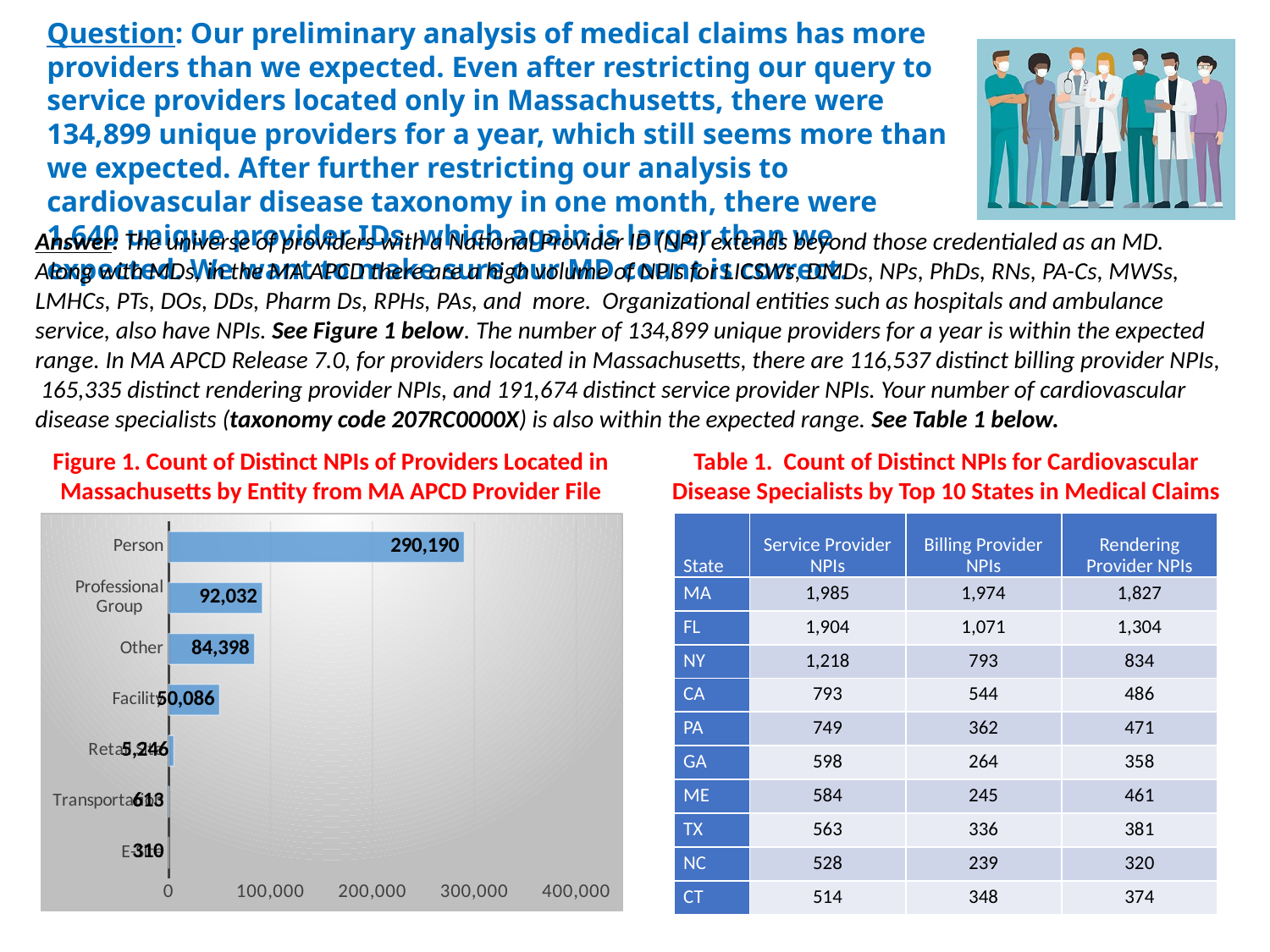
In Figure 1, which entity has the highest count of distinct NPIs? Person How many entity categories are plotted in Figure 1? 7 What is the title of the chart on the slide? Figure 1. Count of Distinct NPIs of Providers Located in Massachusetts by Entity from MA APCD Provider File In Figure 1, is the value for Person greater or less than 200,000? greater In Figure 1, which is larger, the count for Other or the count for Facility? Other What type of chart is Figure 1? bar chart In Figure 1, what is the count of distinct NPIs for Professional Group? 92,032 In Figure 1, what is the count of distinct NPIs for Other? 84,398 In Figure 1, what is the count of distinct NPIs for Facility? 50,086 In Figure 1, what is the difference between the counts for Professional Group and Other? 7,634 In Figure 1, what is the count of distinct NPIs for Person? 290,190 In Figure 1, what is the difference between the counts for Person and Professional Group? 198,158